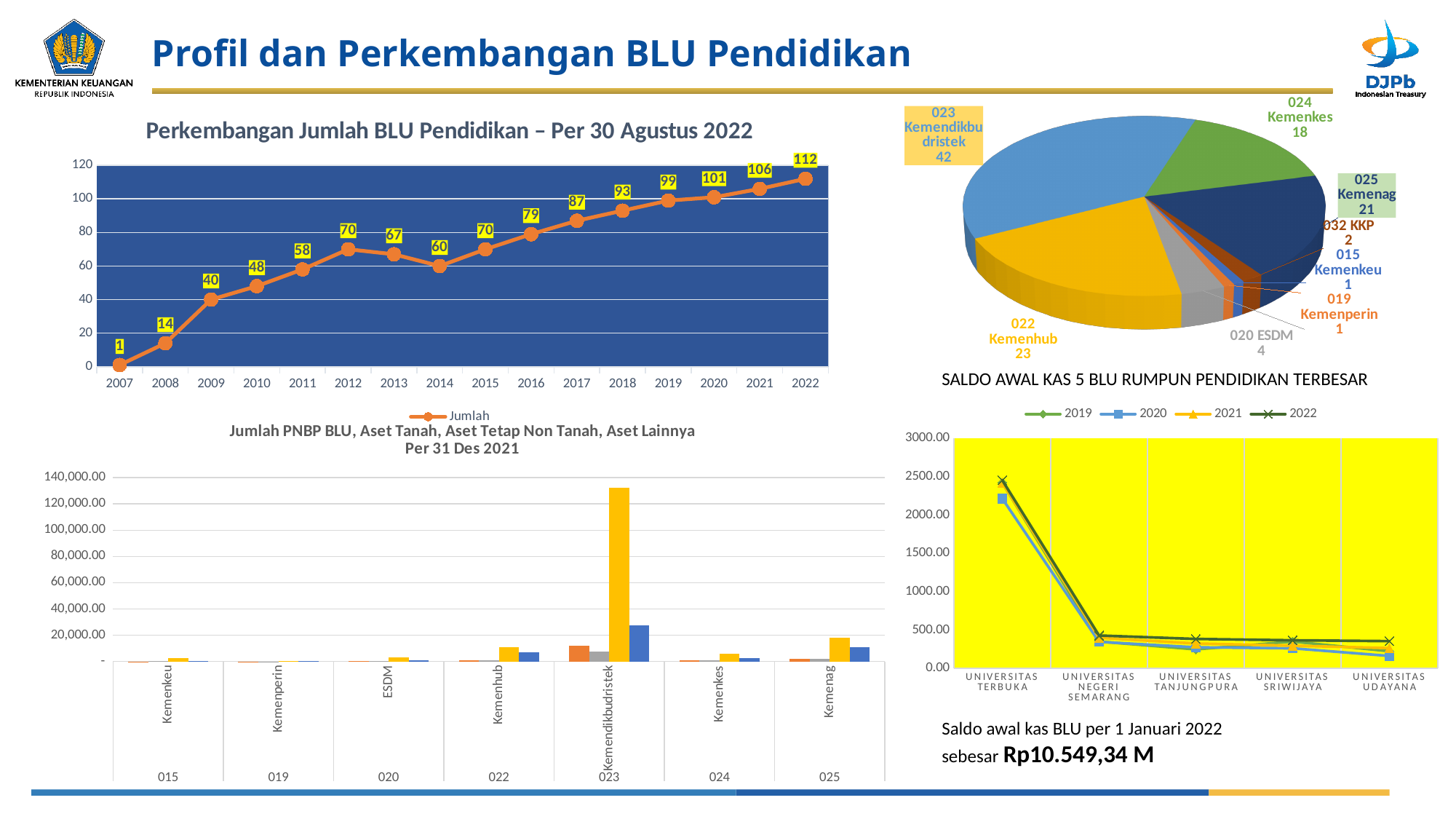
In the pie chart at the top right, which is larger: 024 Kemenkes or 025 Kemenag? 025 Kemenag In the chart 'SALDO AWAL KAS 5 BLU RUMPUN PENDIDIKAN TERBESAR', is the 2022 value for Universitas Terbuka greater or less than 2000.00? greater In the pie chart at the top right, what is the value for 022 Kemenhub? 23 In the chart 'Perkembangan Jumlah BLU Pendidikan – Per 30 Agustus 2022', what kind of chart is used? Line chart In the chart 'SALDO AWAL KAS 5 BLU RUMPUN PENDIDIKAN TERBESAR', how many series does the legend list? 4 In the chart 'Perkembangan Jumlah BLU Pendidikan – Per 30 Agustus 2022', what is the value for 2022? 112 In the chart 'Perkembangan Jumlah BLU Pendidikan – Per 30 Agustus 2022', what is the difference between the values for 2022 and 2021? 6 In the chart 'Perkembangan Jumlah BLU Pendidikan – Per 30 Agustus 2022', how many years are plotted on the x axis? 16 In the pie chart at the top right, which category has the largest slice? 023 Kemendikbudristek In the bar chart 'Jumlah PNBP BLU, Aset Tanah, Aset Tetap Non Tanah, Aset Lainnya Per 31 Des 2021', which category has the tallest bar? Kemendikbudristek In the chart 'Perkembangan Jumlah BLU Pendidikan – Per 30 Agustus 2022', which year has the lowest value? 2007 In the chart 'Perkembangan Jumlah BLU Pendidikan – Per 30 Agustus 2022', what is the value for 2014? 60